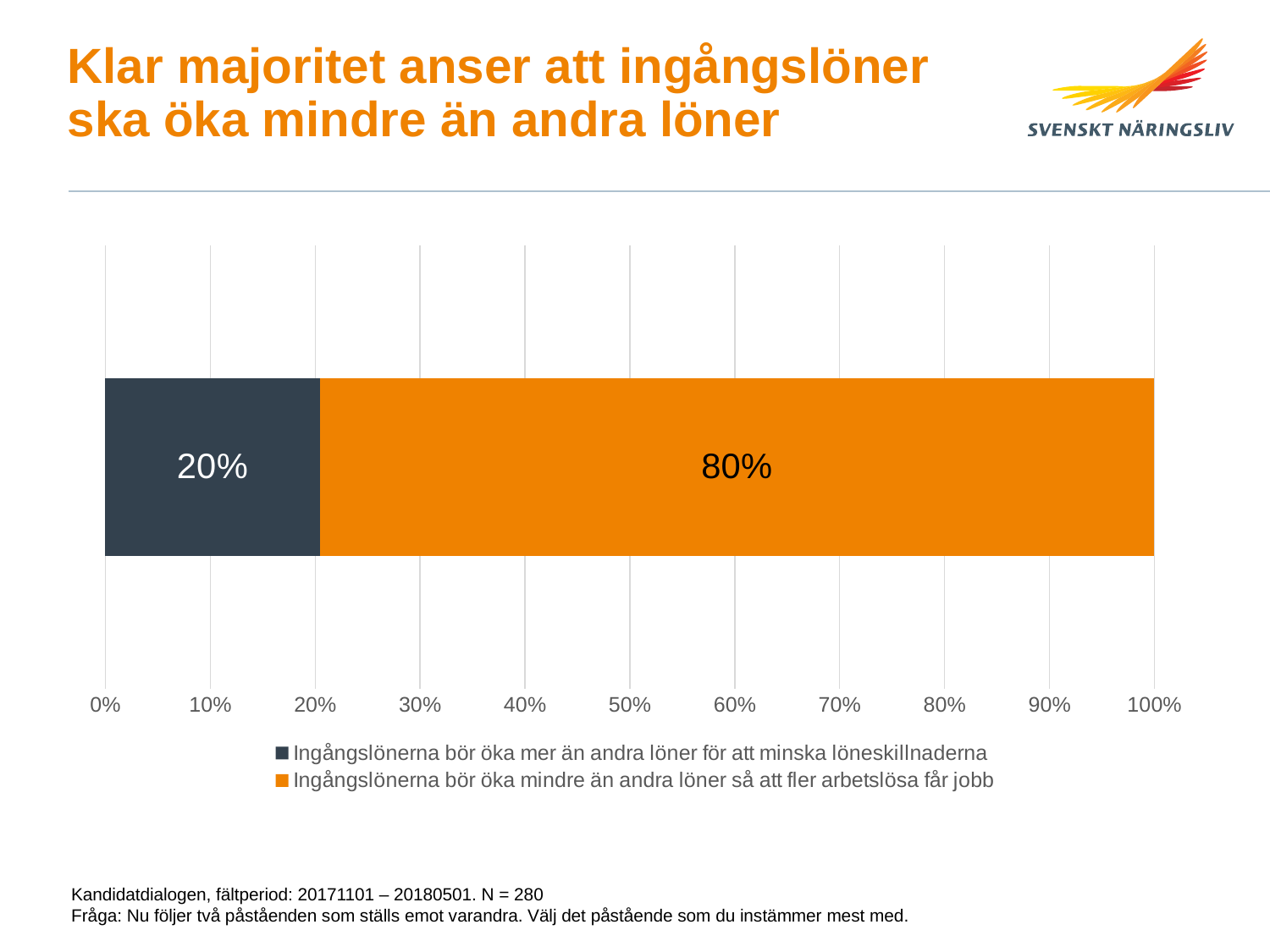
What percentage of respondents chose "Ingångslönerna bör öka mindre än andra löner så att fler arbetslösa får jobb"? 80% How many series does the legend list? 2 What colour is the segment representing "Ingångslönerna bör öka mindre än andra löner så att fler arbetslösa får jobb"? Orange What is the maximum value shown on the x axis? 100% What is the total of the two segments in the stacked bar? 100% What is the difference in percentage points between the two statements' shares? 60 percentage points Is the share for the orange segment greater or less than 70%? greater What percentage of respondents chose "Ingångslönerna bör öka mer än andra löner för att minska löneskillnaderna"? 20% What kind of chart is shown on the slide? Stacked horizontal bar chart Is the share for "Ingångslönerna bör öka mer än andra löner för att minska löneskillnaderna" greater or less than 50%? less Which statement received the smaller share of responses? Ingångslönerna bör öka mer än andra löner för att minska löneskillnaderna Which statement received the larger share of responses? Ingångslönerna bör öka mindre än andra löner så att fler arbetslösa får jobb